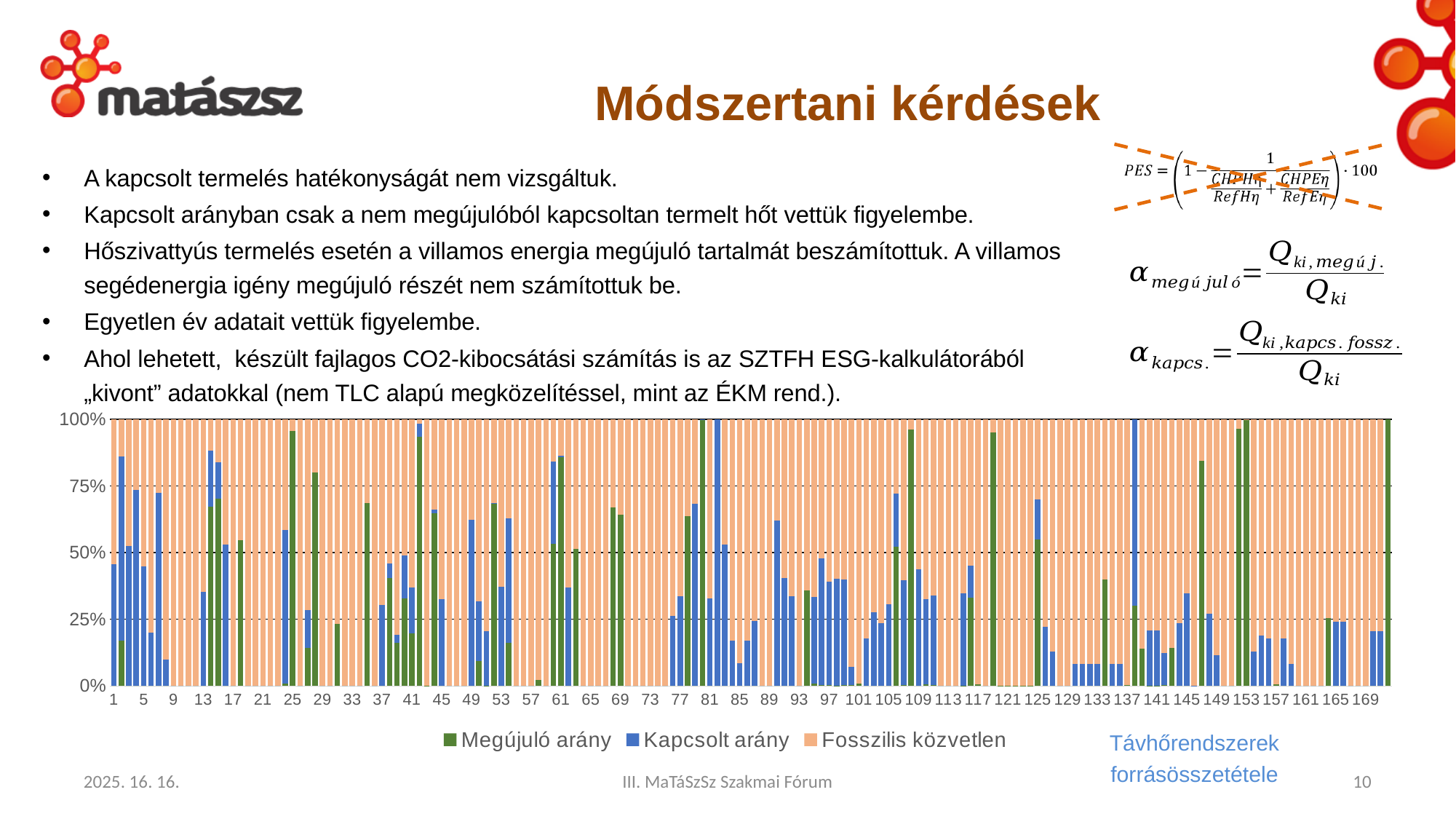
Is the Kapcsolt arány value for category 137 greater or less than 75%? less Is the Megújuló arány value for category 25 greater or less than 75%? greater What is the highest value shown on the vertical axis of the chart? 100% Is the Kapcsolt arány value for category 1 greater or less than 50%? less What kind of chart is shown on the slide? stacked bar chart Which series is shown in green in the chart? Megújuló arány What is the total of each stacked bar in the chart? 100% How many series does the chart legend list? 3 Which series is shown in orange in the chart? Fosszilis közvetlen